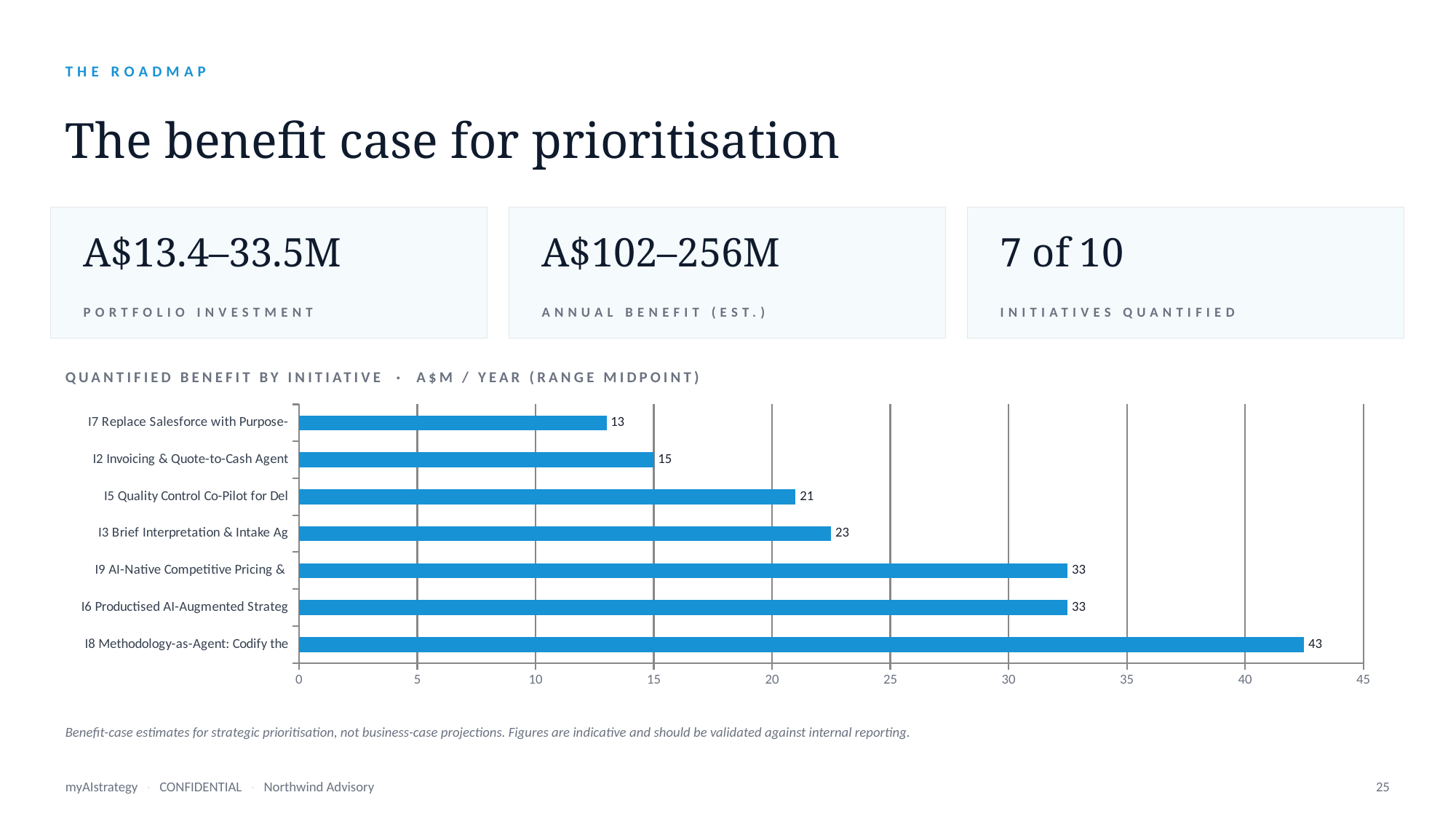
How many initiatives are plotted in the chart? 7 Which has a larger value, I5 Quality Control Co-Pilot or I2 Invoicing & Quote-to-Cash Agent? I5 Quality Control Co-Pilot What is the difference between the values for I8 Methodology-as-Agent and I7 Replace Salesforce? 30 Is the value for I9 AI-Native Competitive Pricing greater or less than 30? greater What type of chart is shown on the slide? Bar chart Which initiative has the lowest quantified benefit? I7 Replace Salesforce What is the value shown for I7 Replace Salesforce? 13 What is the quantified benefit value for I8 Methodology-as-Agent? 43 What is the value shown for I3 Brief Interpretation & Intake? 23 What is the value shown for I5 Quality Control Co-Pilot? 21 Which initiative has the highest quantified benefit? I8 Methodology-as-Agent What unit does the chart title say the values are in? A$M / year (range midpoint)